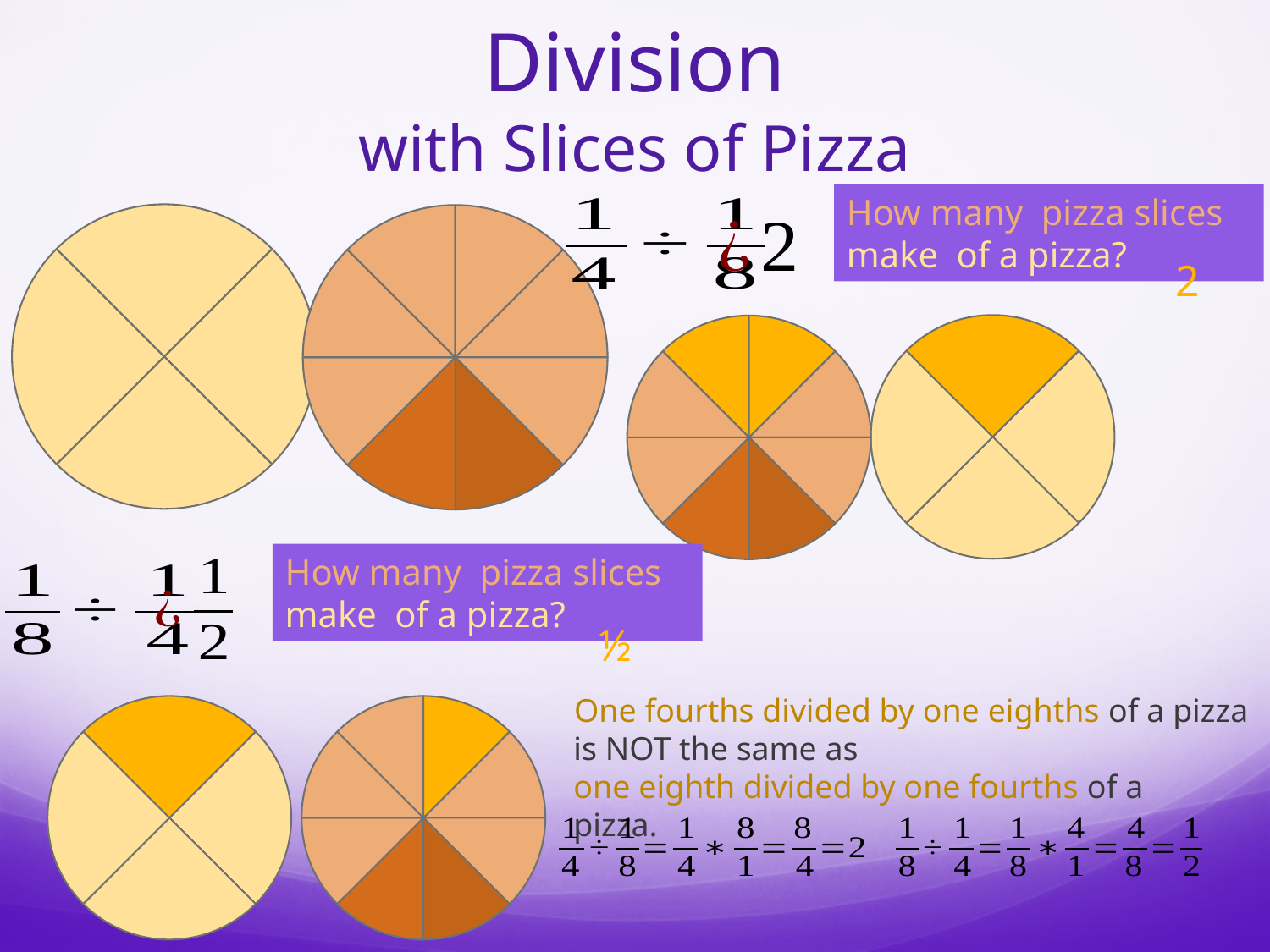
Which has more slices, the top-left pizza or the second pizza from the left in the top row? the second pizza from the left in the top row In the second pizza from the left in the bottom row, how many slices are shaded dark orange? 2 What fraction of the top-left pizza does one slice represent? 1/4 How many slices is the second pizza from the left in the bottom row divided into? 8 How many slices is the second pizza from the left in the top row divided into? 8 What is the title of the slide? Division with Slices of Pizza What fraction of the eight-slice pizza in the top row does one slice represent? 1/8